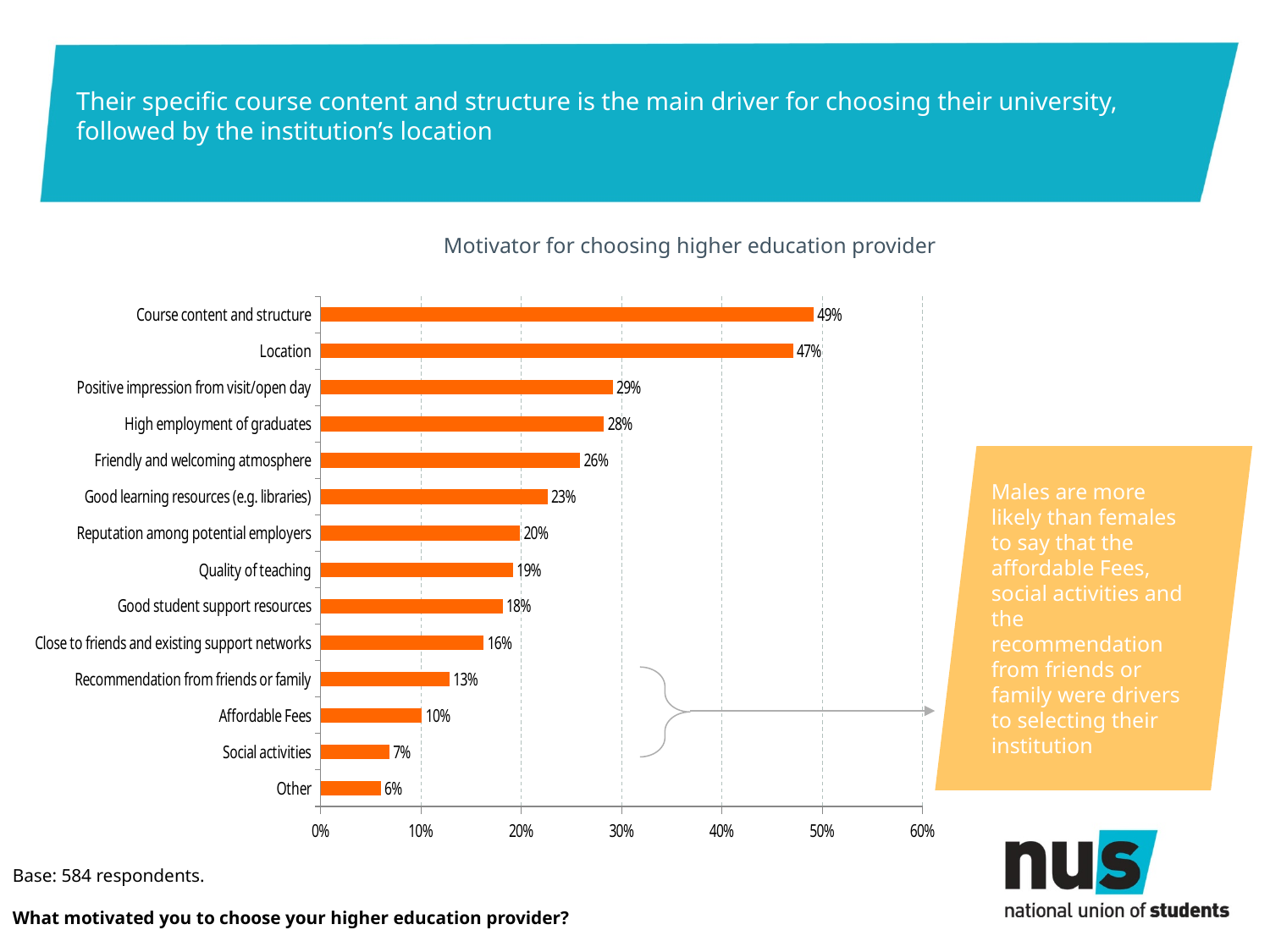
What is the value for Good learning resources (e.g. libraries)? 23% What is the value for Affordable Fees? 10% What is the value for Location? 47% Which is larger, the value for Quality of teaching or the value for Good student support resources? Quality of teaching What is the title of the chart? Motivator for choosing higher education provider What is the value for Course content and structure? 49% How many categories are shown in the chart? 14 What is the difference between the values for Course content and structure and Location? 2% Which category has the highest value? Course content and structure Which category has the lowest value? Other What kind of chart is shown on the slide? Bar chart What is the difference between the values for Positive impression from visit/open day and Social activities? 22%